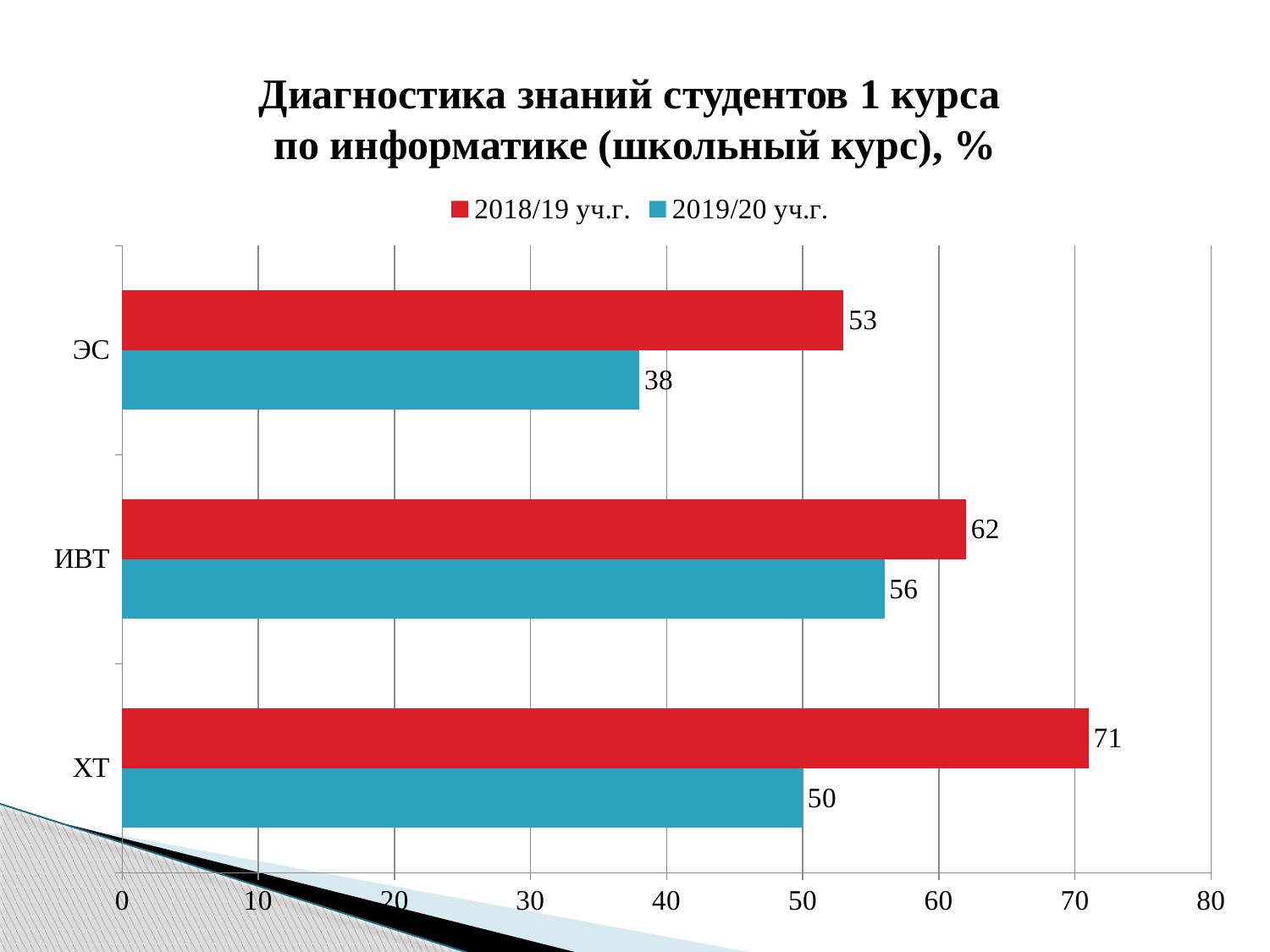
How many categories are shown on the chart? 3 What is the value for ИВТ in 2019/20 уч.г.? 56 What is the value for ЭС in 2018/19 уч.г.? 53 How many series does the legend list? 2 Which is larger: the 2019/20 уч.г. value for ИВТ or the 2018/19 уч.г. value for ЭС? 2019/20 уч.г. value for ИВТ What kind of chart is shown on the slide? Bar chart What is the value for ХТ in 2019/20 уч.г.? 50 What is the difference between the 2018/19 уч.г. and 2019/20 уч.г. values for ХТ? 21 Which category has the lowest value in 2019/20 уч.г.? ЭС Which category has the highest value in 2018/19 уч.г.? ХТ Which colour represents 2019/20 уч.г. in the chart? Blue What is the difference between the 2018/19 уч.г. and 2019/20 уч.г. values for ЭС? 15